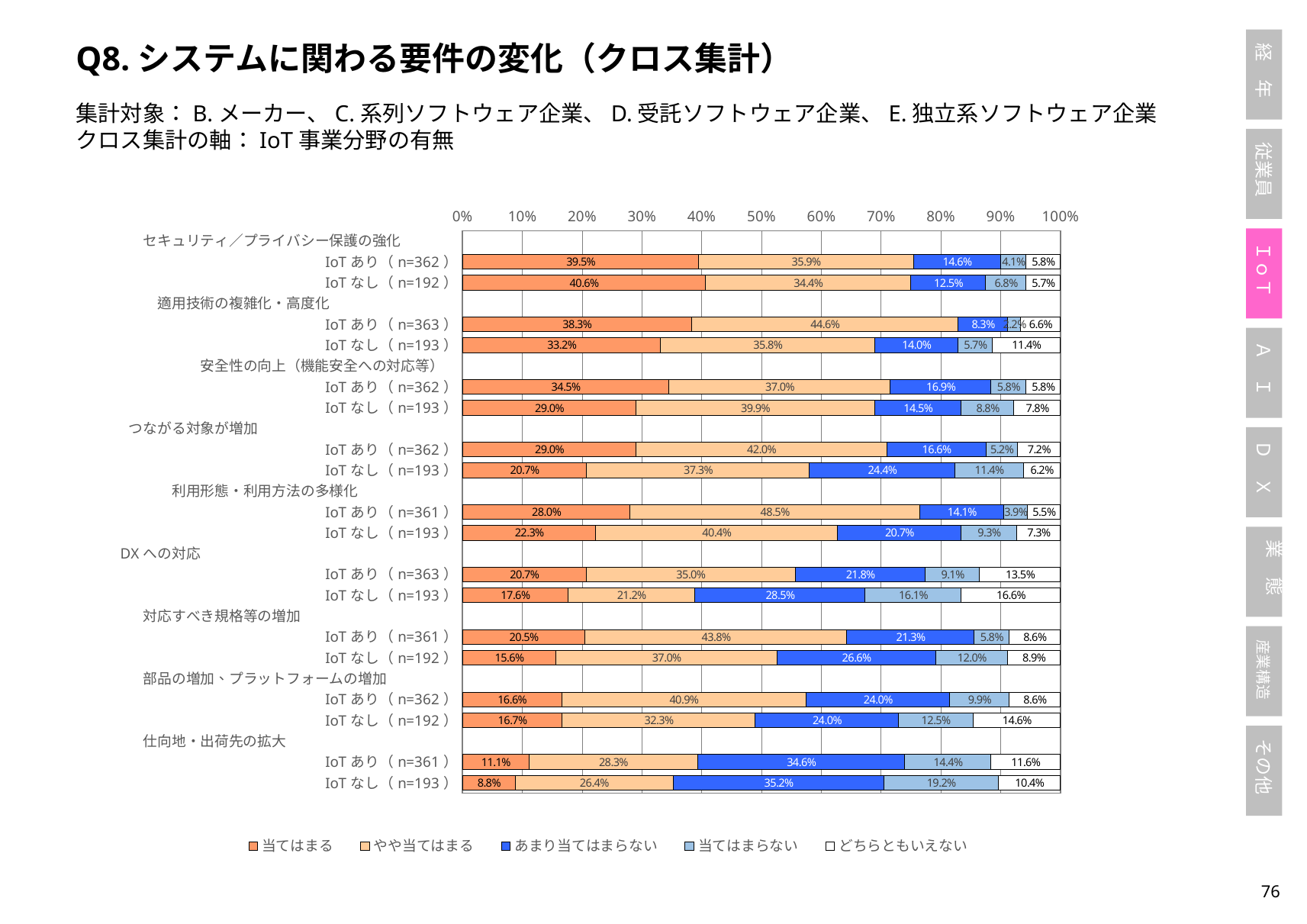
What is the どちらともいえない value for DX への対応, IoT なし (n=193)? 16.6% What is the 当てはまらない value for 仕向地・出荷先の拡大, IoT なし (n=193)? 19.2% What is the first entry in the legend? 当てはまる What is the 当てはまる value for セキュリティ／プライバシー保護の強化, IoT あり (n=362)? 39.5% For つながる対象が増加, which has the larger 当てはまらない value, IoT あり or IoT なし? IoT なし How many series does the legend list? 5 What kind of chart is shown on the slide? Stacked bar chart For DX への対応, what is the difference in the 当てはまる value between IoT あり and IoT なし? 3.1 percentage points How many bars are plotted in the chart? 18 Which bar has the highest 当てはまる value? セキュリティ／プライバシー保護の強化, IoT なし (40.6%) What is the やや当てはまる value for 利用形態・利用方法の多様化, IoT あり (n=361)? 48.5% Which bar has the lowest 当てはまる value? 仕向地・出荷先の拡大, IoT なし (8.8%)